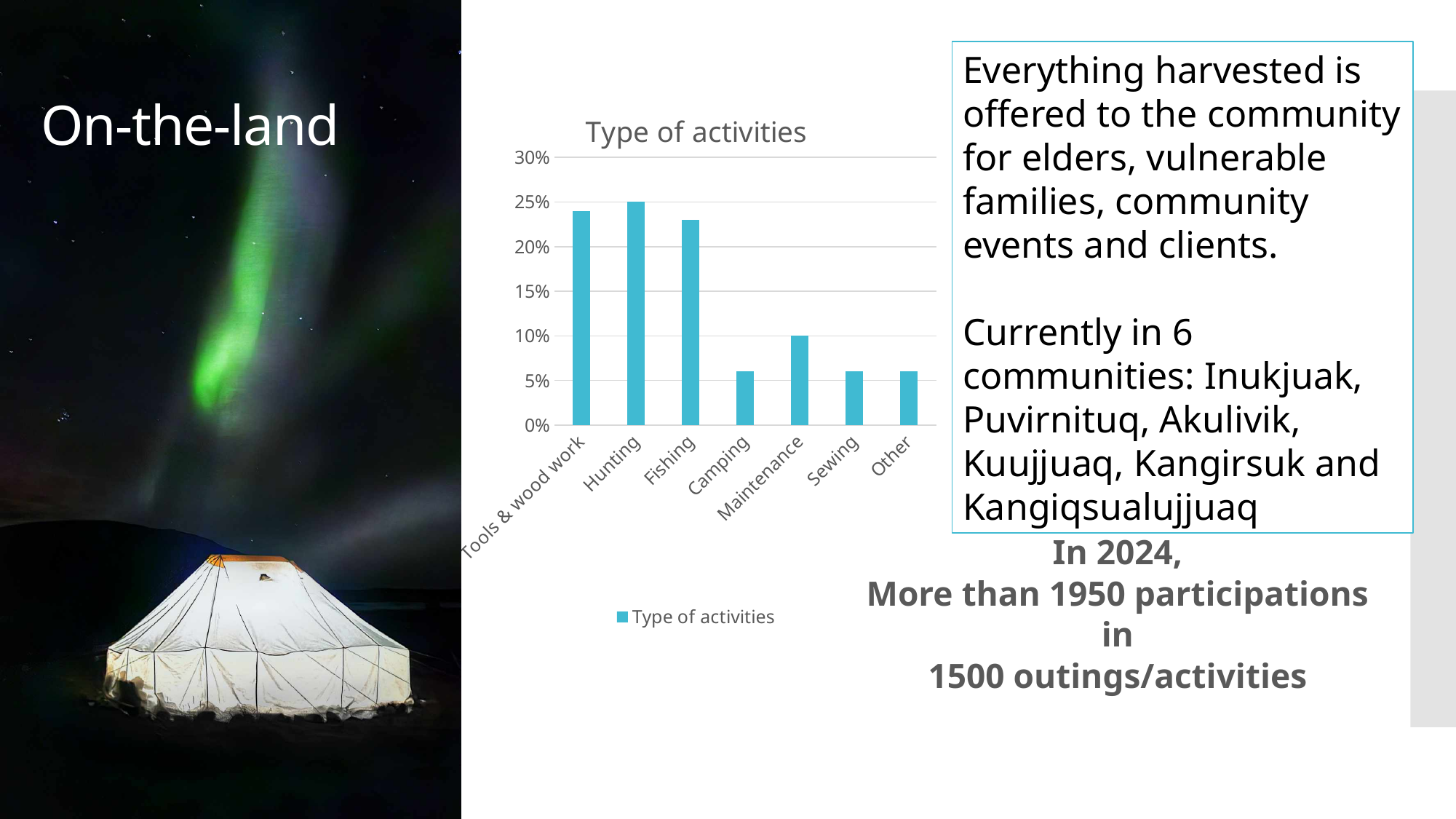
What is the value for Hunting? 25% What type of chart is shown on the slide? bar chart How many series does the chart legend list? 1 Which is larger, the value for Fishing or the value for Sewing? Fishing What is the title of the chart? Type of activities How many categories are shown on the x axis of the chart? 7 Is the value for Tools & wood work greater or less than 20%? greater Which is larger, the value for Maintenance or the value for Camping? Maintenance What is the value for Maintenance? 10% Is the value for Camping greater or less than 10%? less Is the value for Fishing greater or less than 20%? greater